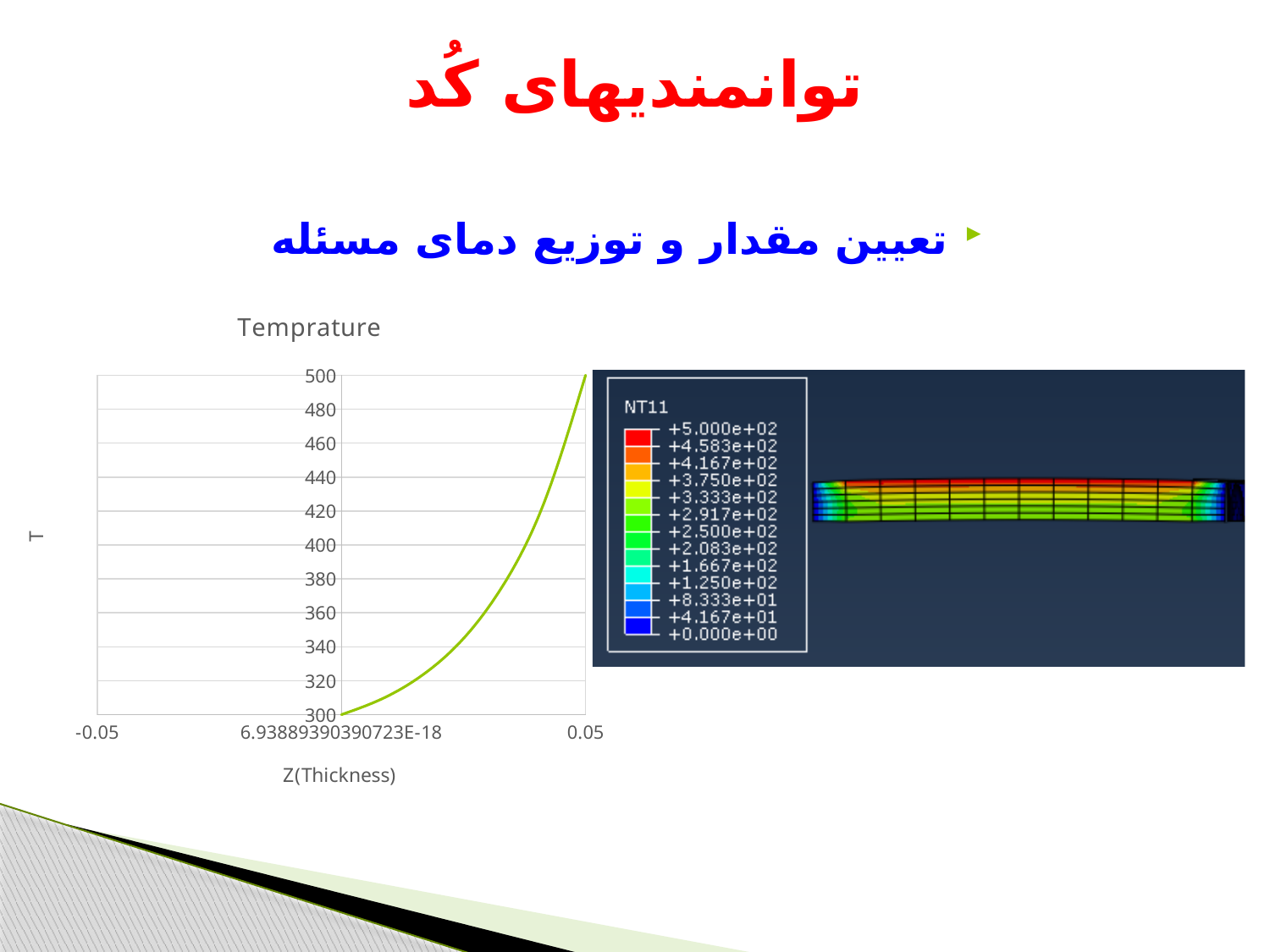
In the "Temprature" chart, which is larger: the value of T at Z(Thickness) = 0.05 or at the tick labelled 6.93889390390723E-18? Z(Thickness) = 0.05 In the "Temprature" chart, what is the difference between the value of T at Z(Thickness) = 0.05 and at the tick labelled 6.93889390390723E-18? 200 In the "Temprature" chart, what is the lowest value shown on the y-axis? 300 What is the title of the chart on the left of the slide? Temprature In the "Temprature" chart, is the value of T at the x-axis tick labelled 6.93889390390723E-18 greater or less than 400? less In the "Temprature" chart, what is the value of T at the x-axis tick labelled 6.93889390390723E-18? 300 In the "Temprature" chart, is the value of T at Z(Thickness) = 0.05 greater or less than 400? greater In the "Temprature" chart, does the value of T rise or fall as Z(Thickness) increases from 0 to 0.05? rise What is the x-axis label of the "Temprature" chart? Z(Thickness) In the "Temprature" chart, what is the value of T at Z(Thickness) = 0.05? 500 What kind of chart is the chart titled "Temprature"? line chart In the "Temprature" chart, at which x-axis tick does the curve reach its highest value of T? 0.05